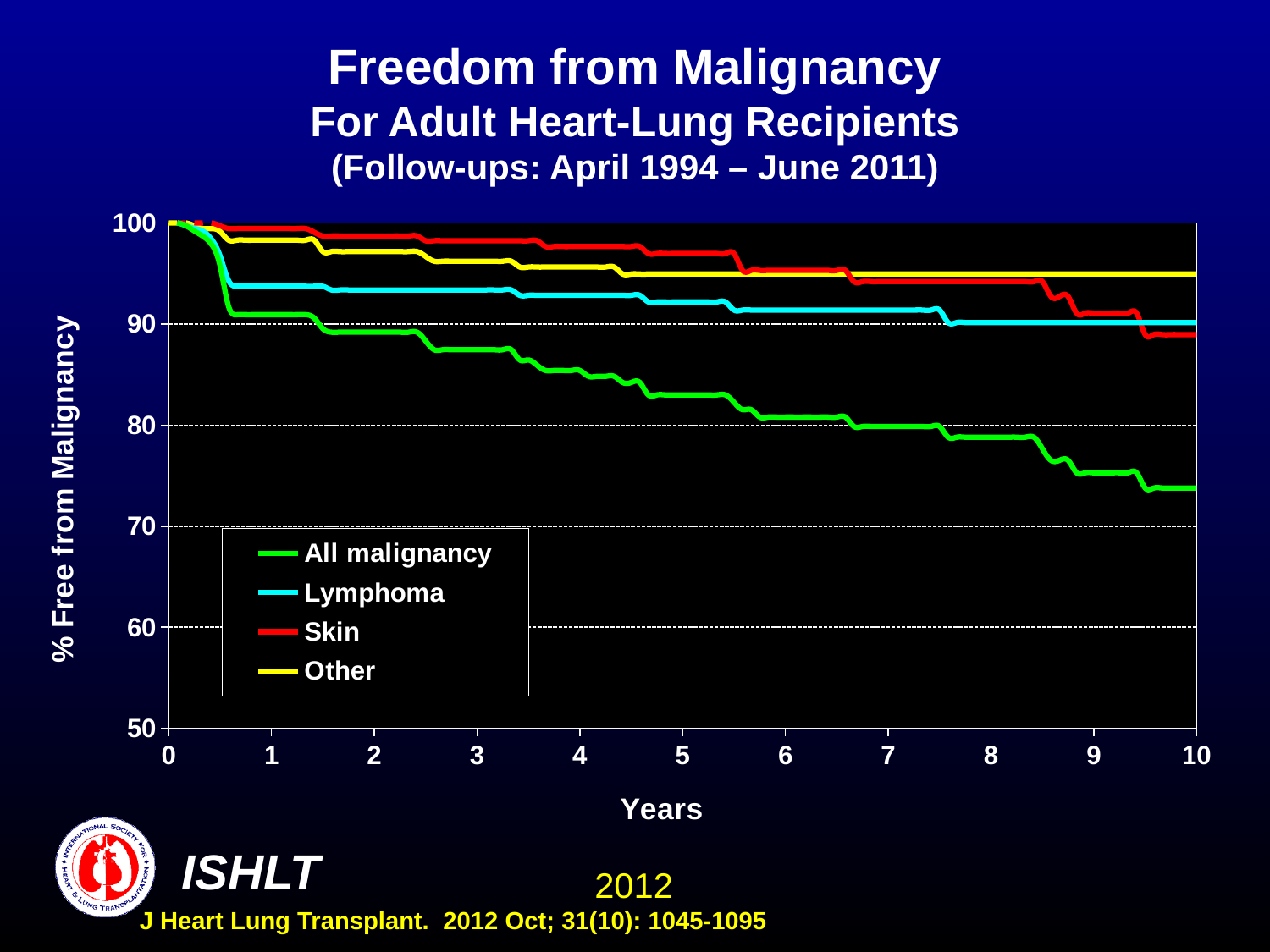
Which series has the highest value at 10 years? Other Is the value for Other at 10 years greater or less than 90? greater What is the label of the y axis? % Free from Malignancy Is the value for All malignancy at 10 years greater or less than 80? less Is the value for All malignancy at 5 years greater or less than 80? greater What kind of chart is shown on the slide? line chart How many series does the legend list? 4 Do the values for All malignancy rise or fall as years increase? fall At 10 years, which is larger: the value for Other or the value for All malignancy? Other What colour is the line for Lymphoma? cyan Which series has the lowest value at 10 years? All malignancy